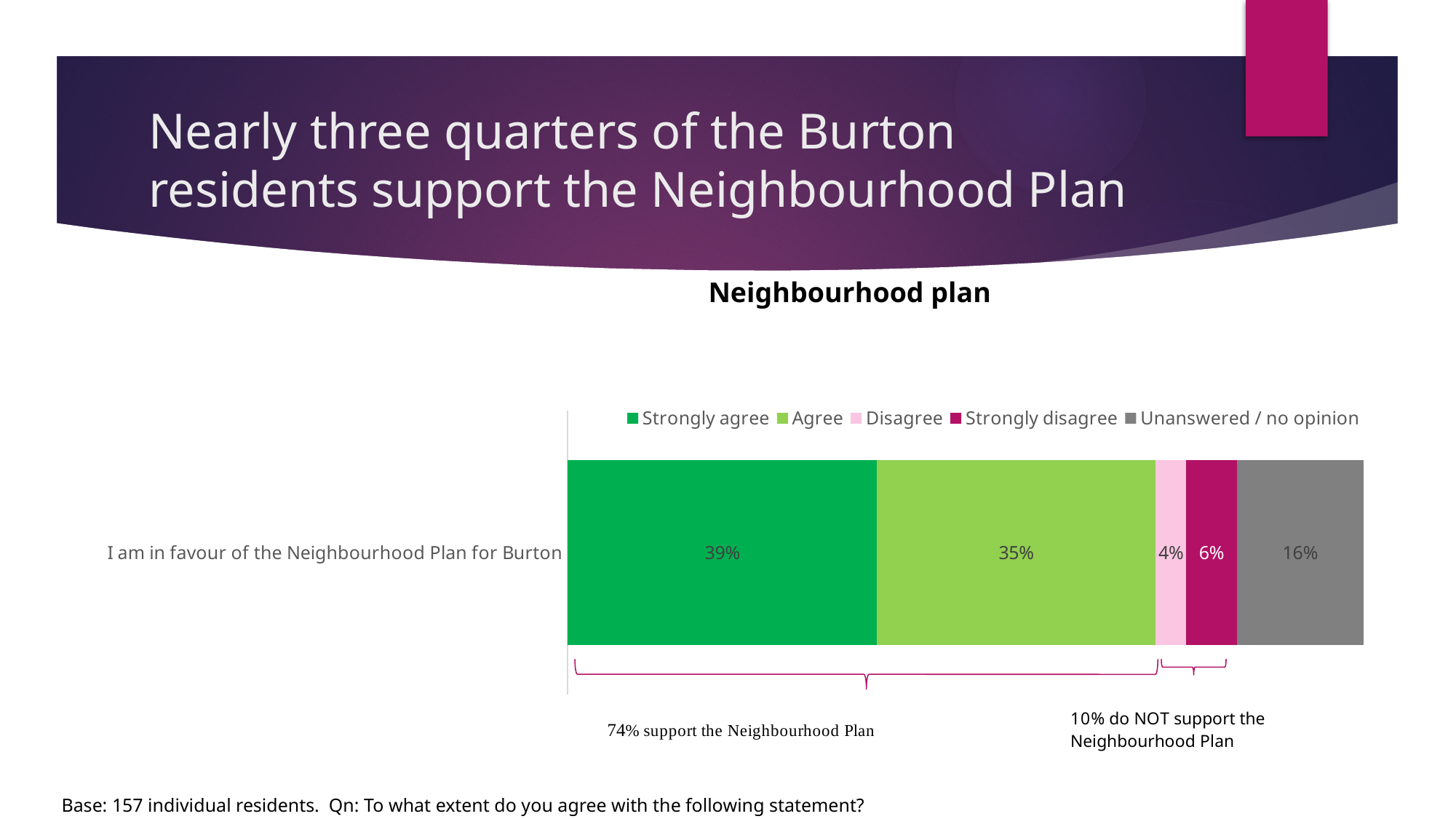
What percentage of respondents chose 'Strongly disagree'? 6% Which is larger, the 'Strongly disagree' share or the 'Disagree' share? Strongly disagree Which response category has the largest share of the bar? Strongly agree Which response category has the smallest share of the bar? Disagree How many series does the legend list? 5 What kind of chart is shown on the slide? Stacked bar chart What percentage of respondents were 'Unanswered / no opinion'? 16% What percentage of respondents chose 'Disagree'? 4% What is the title of the chart? Neighbourhood plan What percentage of respondents chose 'Agree' for the Neighbourhood Plan statement? 35% What percentage of respondents strongly agree with the statement 'I am in favour of the Neighbourhood Plan for Burton'? 39% What is the difference between the 'Strongly agree' and 'Agree' percentages? 4%